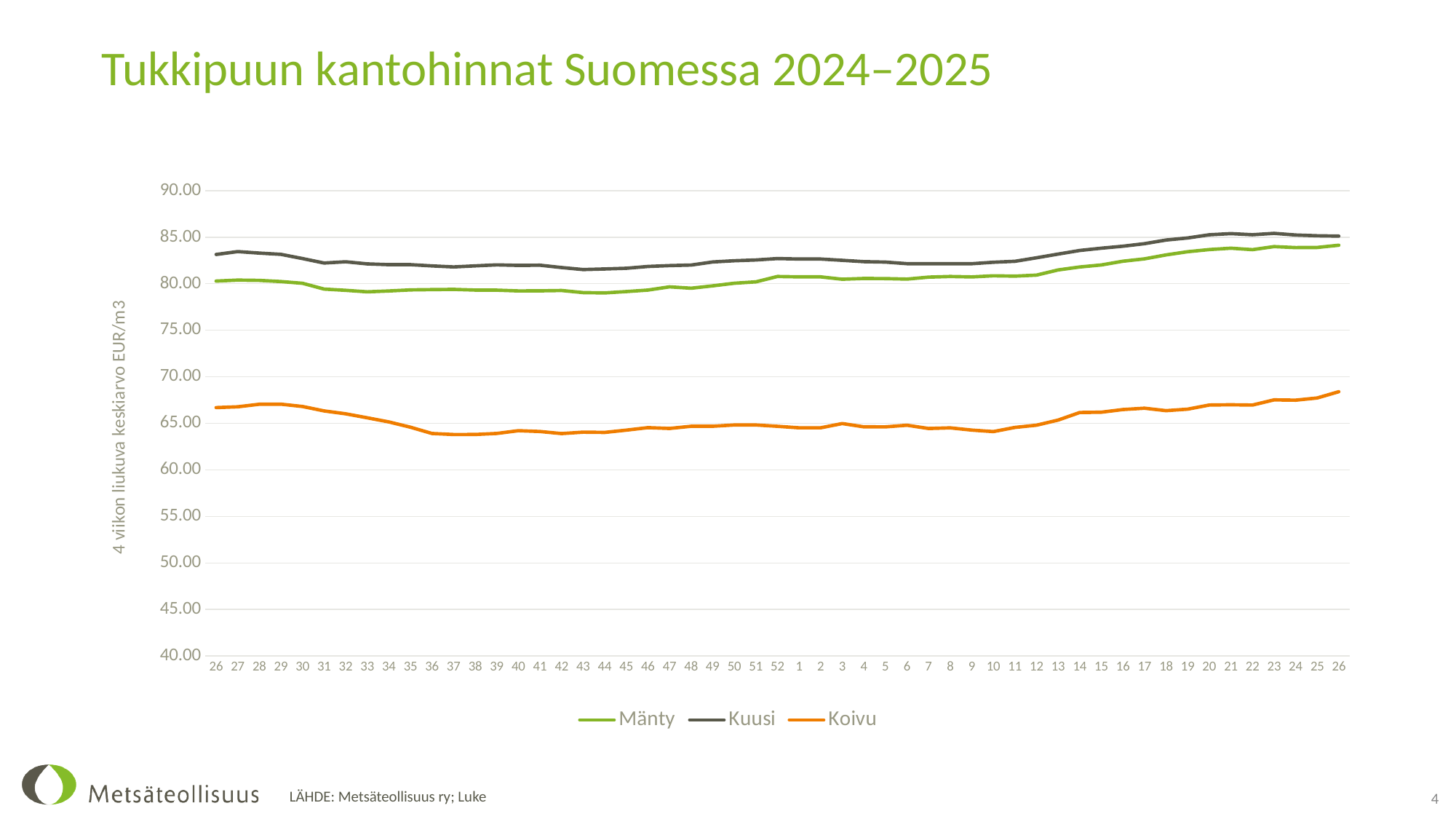
Is the value for Mänty at the final week 26 greater or less than 80.00? greater Does the Mänty line rise or fall between week 12 and week 26 at the end of the chart? Rise Which series has the highest values throughout the chart? Kuusi How many series does the legend list? 3 At week 40, which is larger, the value for Kuusi or the value for Mänty? Kuusi What is the title of the chart? Tukkipuun kantohinnat Suomessa 2024–2025 At week 10, which is larger, the value for Mänty or the value for Koivu? Mänty Is the value for Mänty at week 44 greater or less than 80.00? less Which series has the lowest values throughout the chart? Koivu Is the value for Koivu at week 36 greater or less than 65.00? less What kind of chart is shown on the slide? Line chart Does the Koivu line rise or fall between week 26 and week 36 at the start of the chart? Fall